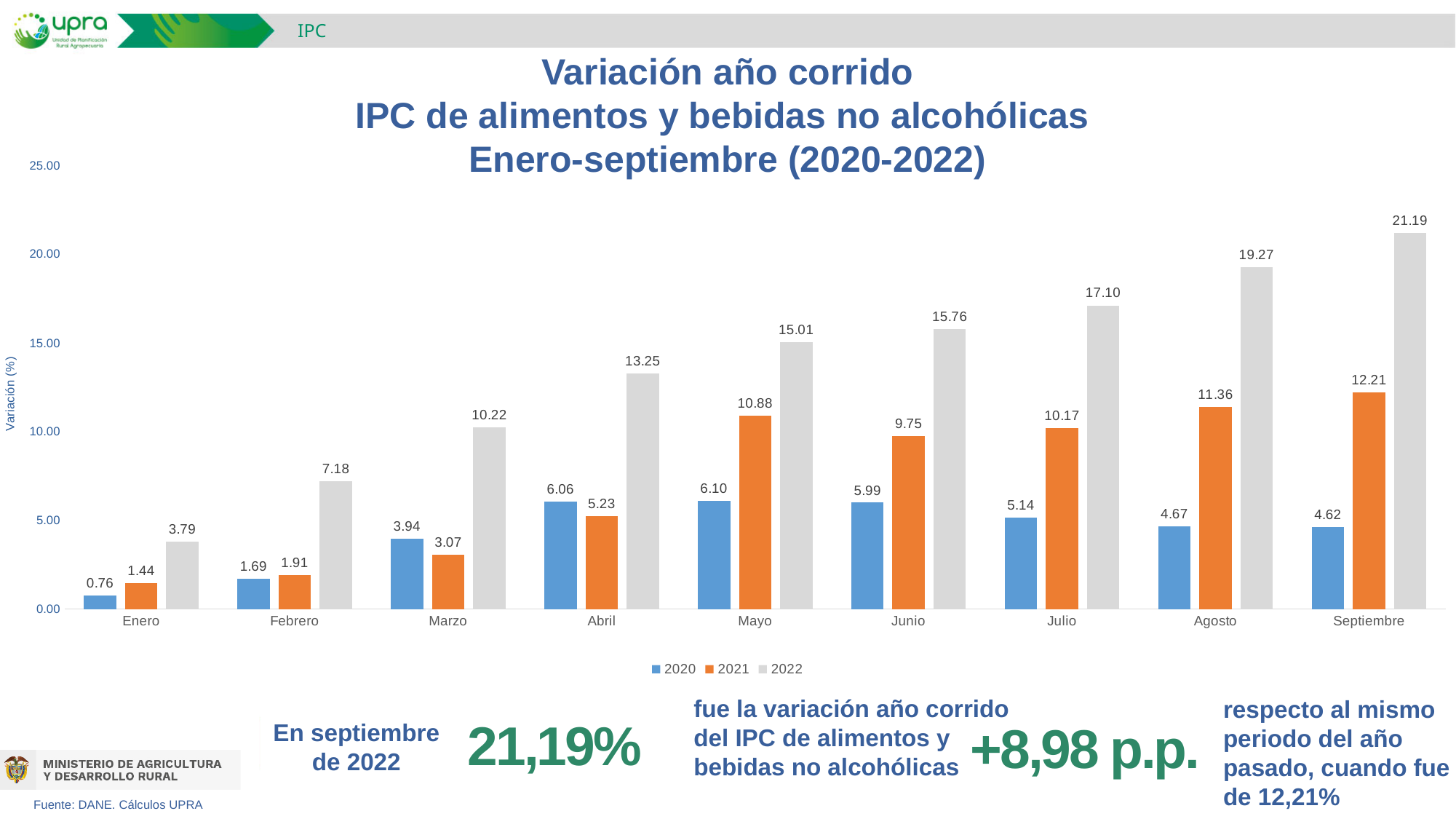
What kind of chart is shown on the slide? bar chart How many months are shown on the x axis? 9 In which month is the 2020 value lowest? Enero What is the value for 2021 in Mayo? 10.88 In which month is the 2022 value highest? Septiembre In Marzo, which series has the larger value, 2020 or 2021? 2020 What is the value for 2020 in Enero? 0.76 What is the value for 2022 in Septiembre? 21.19 Is the value for 2022 in Julio greater or less than 15.00? greater Do the 2022 values rise or fall from Enero to Septiembre? rise How many series does the legend list? 3 What is the difference between the 2022 and 2021 values in Septiembre? 8.98